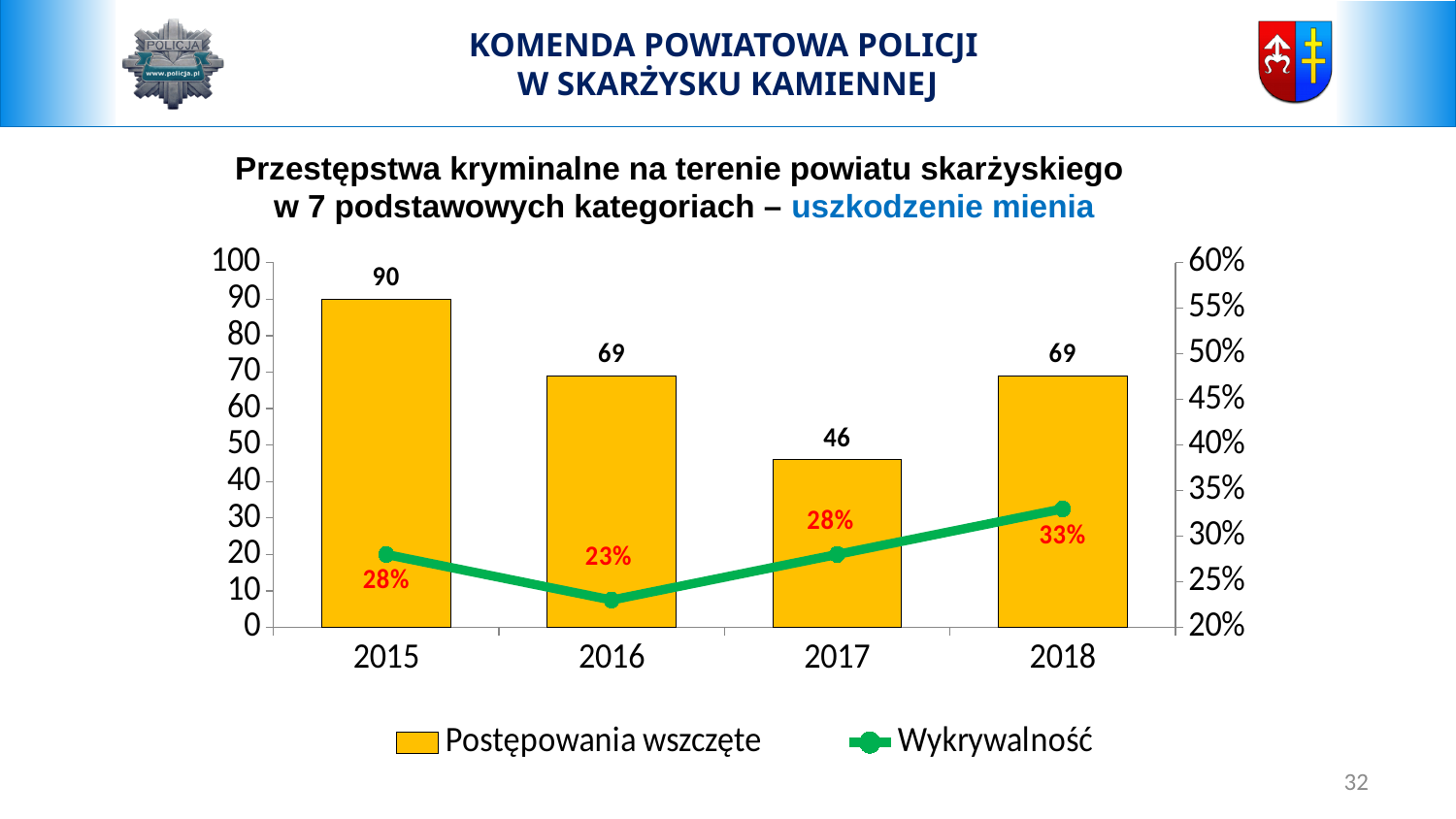
What is the value of Postępowania wszczęte for 2017? 46 How many years are shown on the x axis? 4 How many series does the legend list? 2 Which year has the lowest Wykrywalność? 2016 What is the Wykrywalność value for 2018? 33% Which year has the highest value of Postępowania wszczęte? 2015 What is the value of Postępowania wszczęte for 2015? 90 Which is larger: Postępowania wszczęte in 2016 or in 2017? 2016 What is the Wykrywalność value for 2016? 23% What colour are the Postępowania wszczęte bars? yellow What is the difference between Postępowania wszczęte in 2015 and 2017? 44 Does Wykrywalność rise or fall from 2016 to 2018? rise